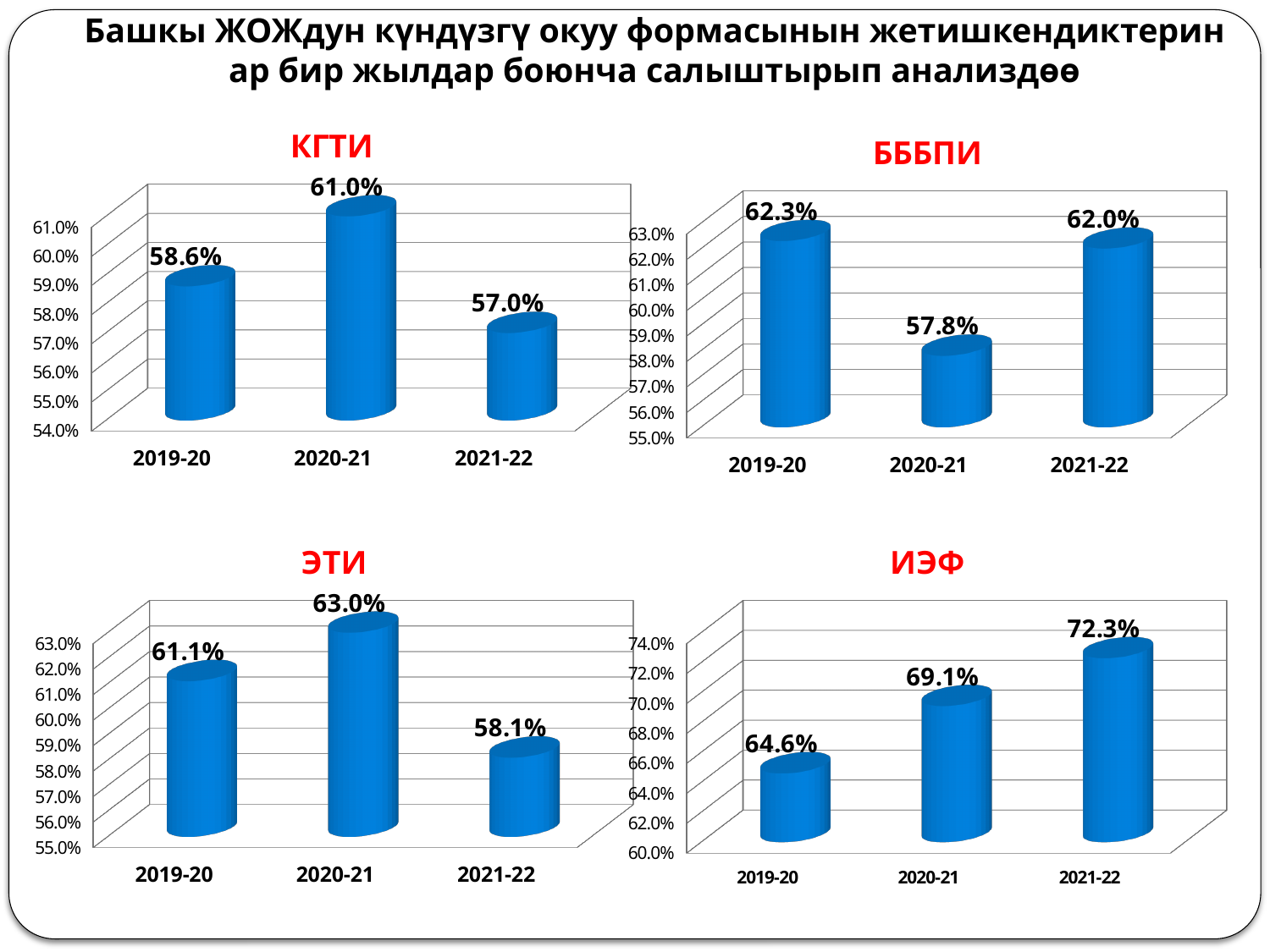
In the КГТИ chart, which year has the lowest value? 2021-22 What kind of chart is the ЭТИ chart? bar chart In the ЭТИ chart, what is the value for 2021-22? 58.1% How many categories are shown on the x axis of the КГТИ chart? 3 In the КГТИ chart, what is the value for 2020-21? 61.0% In the ИЭФ chart, which is larger, the value for 2020-21 or 2021-22? 2021-22 In the БББПИ chart, which year has the lowest value? 2020-21 In the ЭТИ chart, which year has the highest value? 2020-21 In the БББПИ chart, what is the difference between the 2019-20 and 2020-21 values? 4.5% In the ИЭФ chart, do the values rise or fall from 2019-20 to 2021-22? rise In the ИЭФ chart, what is the difference between the 2021-22 and 2019-20 values? 7.7% In the БББПИ chart, what is the value for 2019-20? 62.3%